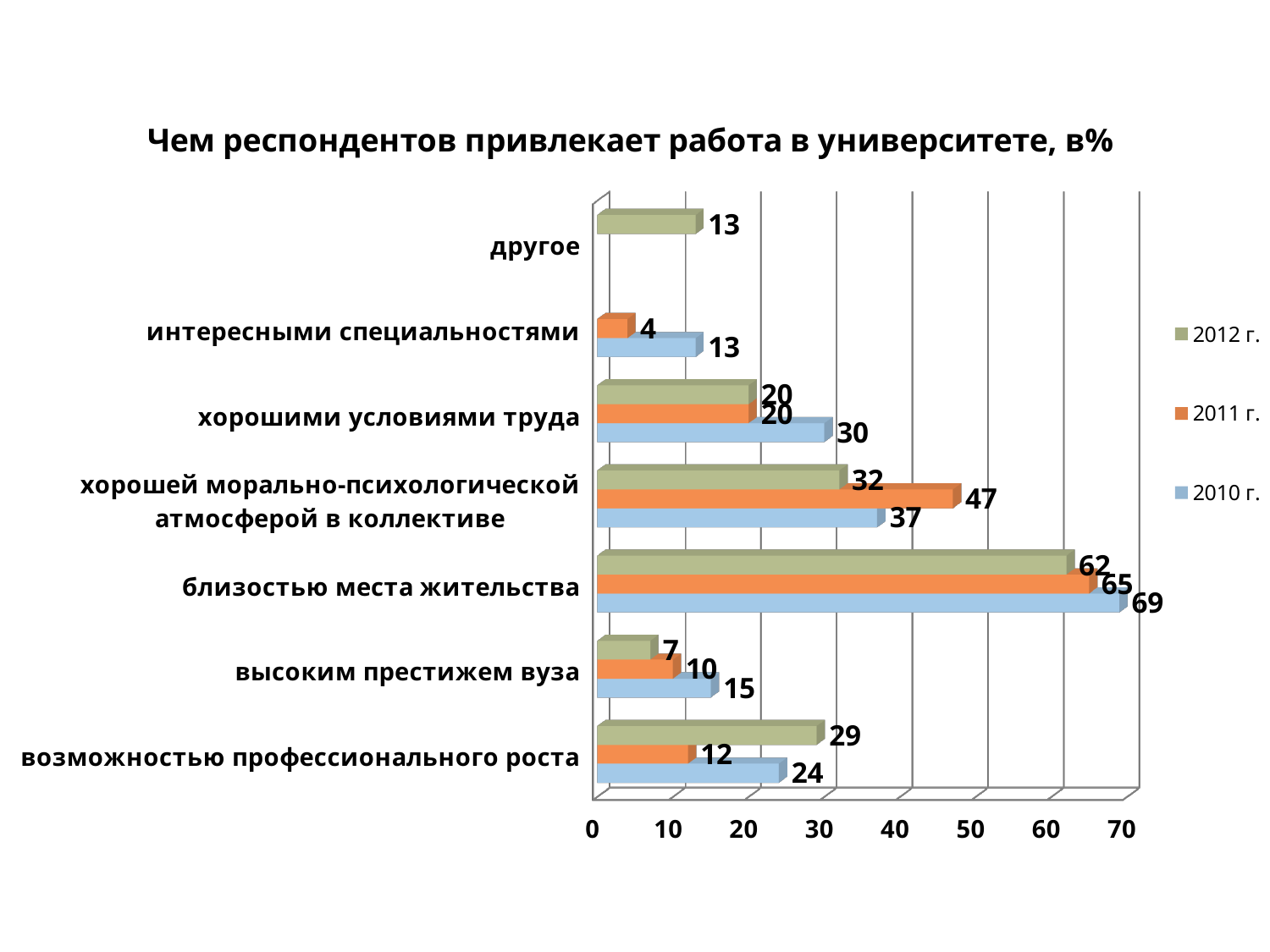
What is the 2011 г. value for «интересными специальностями»? 4 What is the 2011 г. value for «хорошей морально-психологической атмосферой в коллективе»? 47 How many categories are shown on the chart? 7 Which category has the lowest 2010 г. value? интересными специальностями How many series does the legend list? 3 Which is larger for «возможностью профессионального роста»: the 2012 г. value or the 2010 г. value? 2012 г. What is the 2010 г. value for «близостью места жительства»? 69 What is the 2012 г. value for «возможностью профессионального роста»? 29 What is the title of the chart? Чем респондентов привлекает работа в университете, в% Which category has the highest 2012 г. value? близостью места жительства What kind of chart is shown on the slide? bar chart What is the difference between the 2010 г. and 2012 г. values for «близостью места жительства»? 7